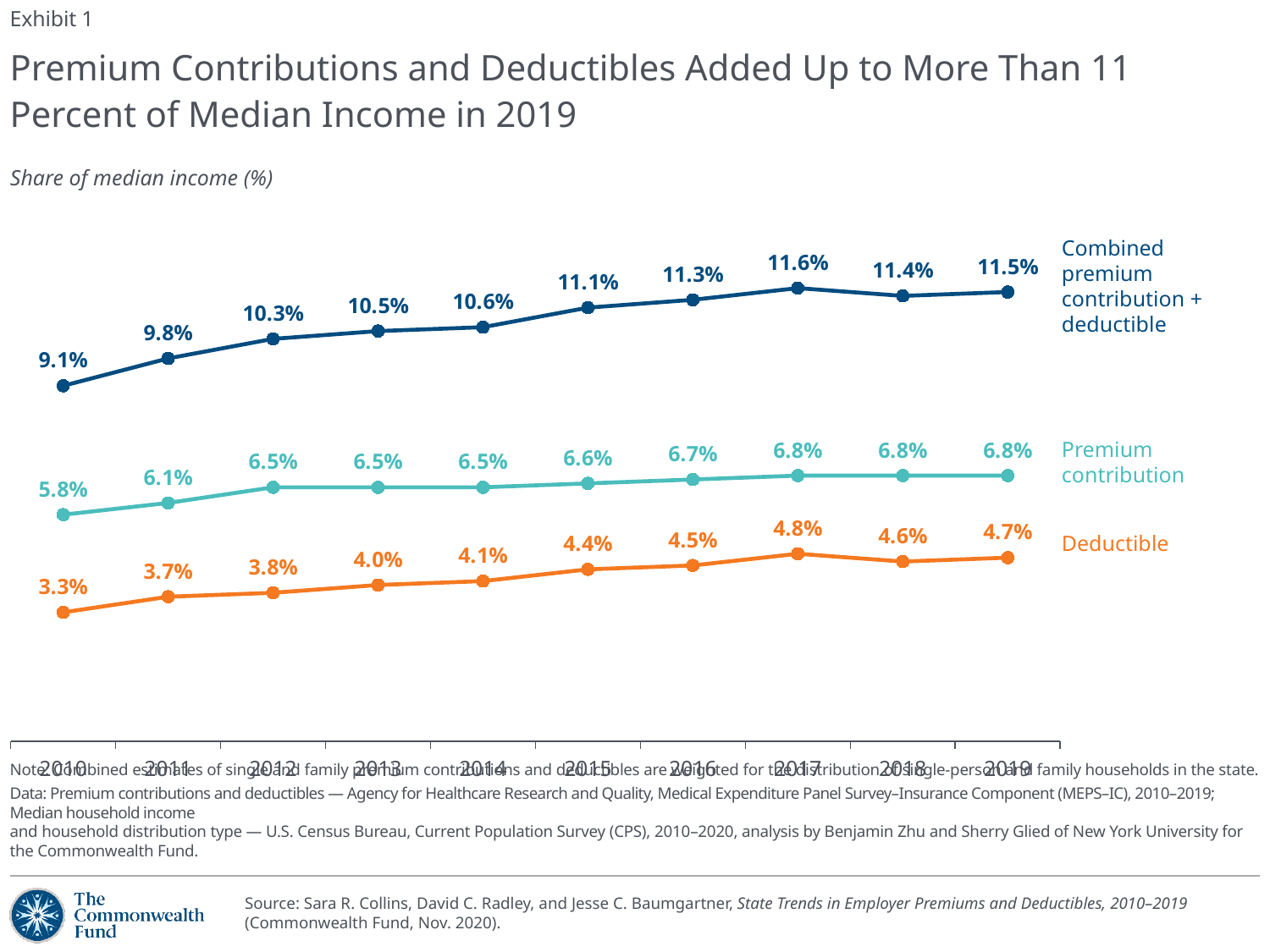
What kind of chart is shown on the slide? Line chart By how many percentage points did the combined premium contribution + deductible share change from 2010 to 2019? 2.4 percentage points Which was larger in 2014, the premium contribution share or the deductible share? Premium contribution How many series are shown in the chart? 3 How many years are plotted on the x axis? 10 Does the deductible share of median income generally rise or fall from 2010 to 2019? Rise What was the deductible share of median income in 2010? 3.3% What was the premium contribution share of median income in 2015? 6.6% In which year was the deductible share of median income lowest? 2010 In which year was the combined premium contribution + deductible share highest? 2017 What was the combined premium contribution + deductible share of median income in 2019? 11.5% What is the difference between the premium contribution share and the deductible share in 2017? 2.0 percentage points